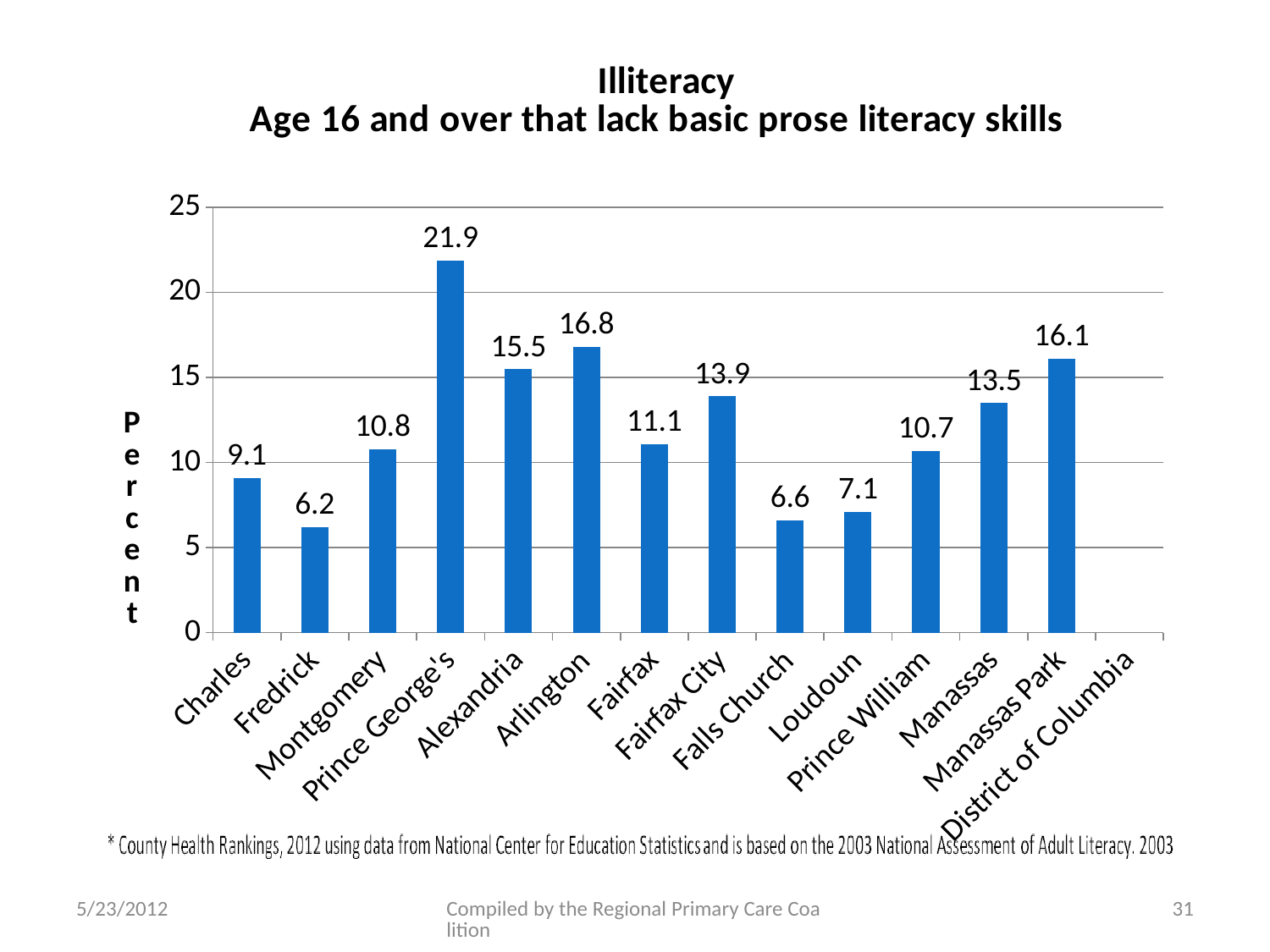
What is the value for Prince George's? 21.9 Which is larger, the value for Fairfax City or the value for Manassas? Fairfax City What kind of chart is shown on the slide? bar chart What is the value for Manassas Park? 16.1 What is the value for Falls Church? 6.6 Is the value for Arlington greater or less than 15? greater Which category has the lowest plotted value? Fredrick What is the difference between the values for Arlington and Alexandria? 1.3 Which category has the highest value? Prince George's How many bars are plotted on the chart? 13 What is the difference between the values for Prince George's and Fredrick? 15.7 What is the label on the vertical axis? Percent